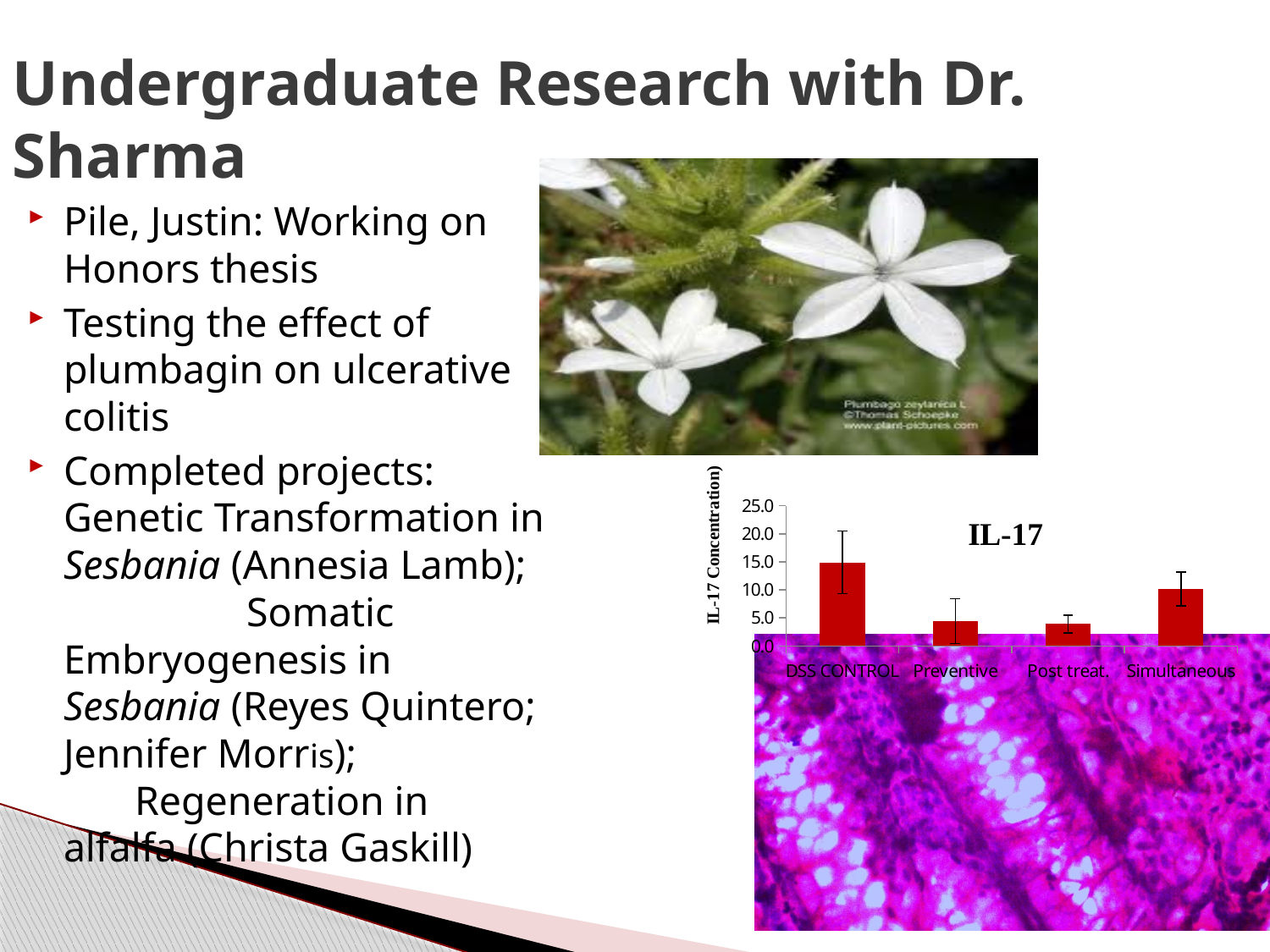
Is the value for DSS CONTROL greater or less than 10.0? greater Which is larger, the value for DSS CONTROL or the value for Simultaneous? DSS CONTROL Is the value for Preventive greater or less than 10.0? less Which category has the highest IL-17 value? DSS CONTROL How many categories are plotted on the x axis of the IL-17 chart? 4 What is the highest tick value shown on the vertical axis? 25.0 What is the label on the vertical axis of the chart? IL-17 Concentration Is the value for Post treat. greater or less than 10.0? less Which is larger, the value for Simultaneous or the value for Preventive? Simultaneous What is the title of the chart? IL-17 What kind of chart is shown on the slide? bar chart